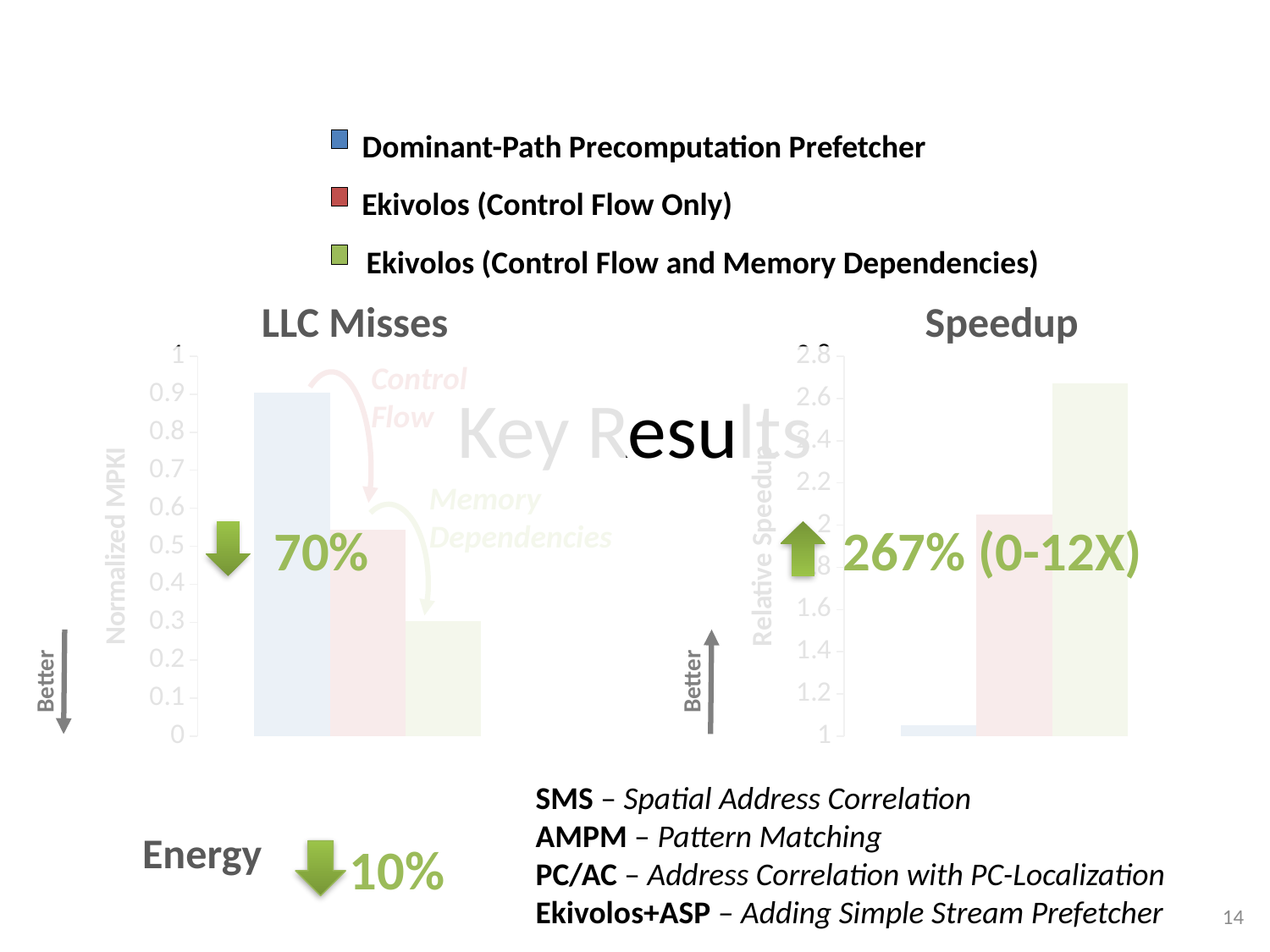
In the Speedup chart, is the value for Ekivolos (Control Flow and Memory Dependencies) greater or less than 2.4? greater How many series does the legend list? 3 What is the y-axis label of the LLC Misses chart? Normalized MPKI In the Speedup chart, which is larger: Ekivolos (Control Flow Only) or Dominant-Path Precomputation Prefetcher? Ekivolos (Control Flow Only) In the LLC Misses chart, which series has the highest bar? Dominant-Path Precomputation Prefetcher What kind of chart is the LLC Misses chart? bar chart In the LLC Misses chart, which series has the lowest bar? Ekivolos (Control Flow and Memory Dependencies) In the Speedup chart, which series has the lowest bar? Dominant-Path Precomputation Prefetcher What is the y-axis label of the Speedup chart? Relative Speedup In the Speedup chart, which series has the highest bar? Ekivolos (Control Flow and Memory Dependencies) In the LLC Misses chart, is the value for Ekivolos (Control Flow and Memory Dependencies) greater or less than 0.4? less In the LLC Misses chart, is the value for Dominant-Path Precomputation Prefetcher greater or less than 0.8? greater